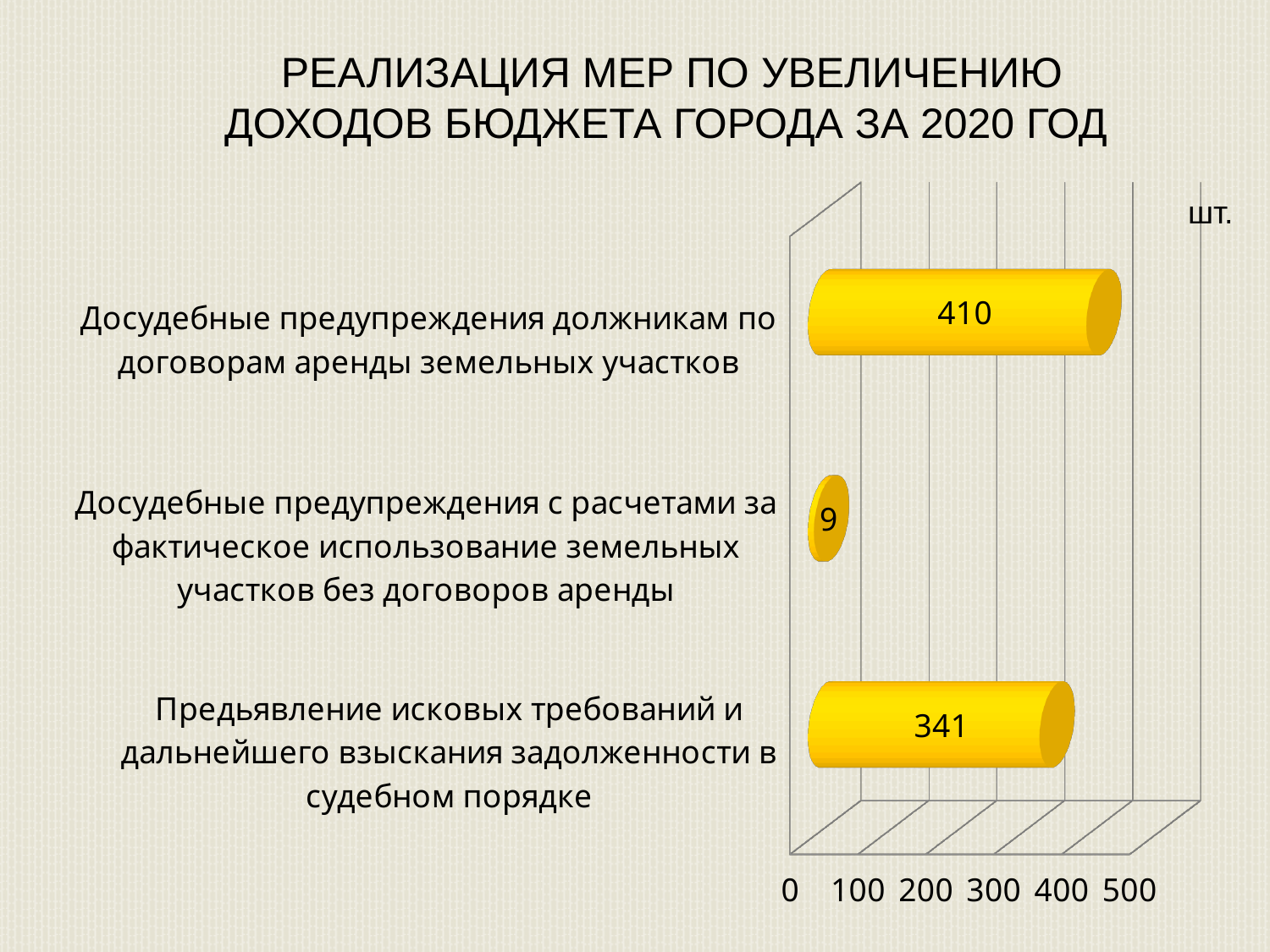
What is the difference between the values for "Досудебные предупреждения должникам по договорам аренды земельных участков" and "Предьявление исковых требований и дальнейшего взыскания задолженности в судебном порядке"? 69 What is the value for "Предьявление исковых требований и дальнейшего взыскания задолженности в судебном порядке"? 341 Which is larger: the value for "Предьявление исковых требований и дальнейшего взыскания задолженности в судебном порядке" or the value for "Досудебные предупреждения с расчетами за фактическое использование земельных участков без договоров аренды"? Предьявление исковых требований и дальнейшего взыскания задолженности в судебном порядке What is the title of the slide? РЕАЛИЗАЦИЯ МЕР ПО УВЕЛИЧЕНИЮ ДОХОДОВ БЮДЖЕТА ГОРОДА ЗА 2020 ГОД What is the value for "Досудебные предупреждения должникам по договорам аренды земельных участков"? 410 What unit label is shown next to the chart? шт. Which category has the highest value? Досудебные предупреждения должникам по договорам аренды земельных участков Is the value for "Предьявление исковых требований и дальнейшего взыскания задолженности в судебном порядке" greater or less than 300? greater How many categories are shown in the chart? 3 What kind of chart is shown on the slide? bar chart What is the value for "Досудебные предупреждения с расчетами за фактическое использование земельных участков без договоров аренды"? 9 Which category has the lowest value? Досудебные предупреждения с расчетами за фактическое использование земельных участков без договоров аренды